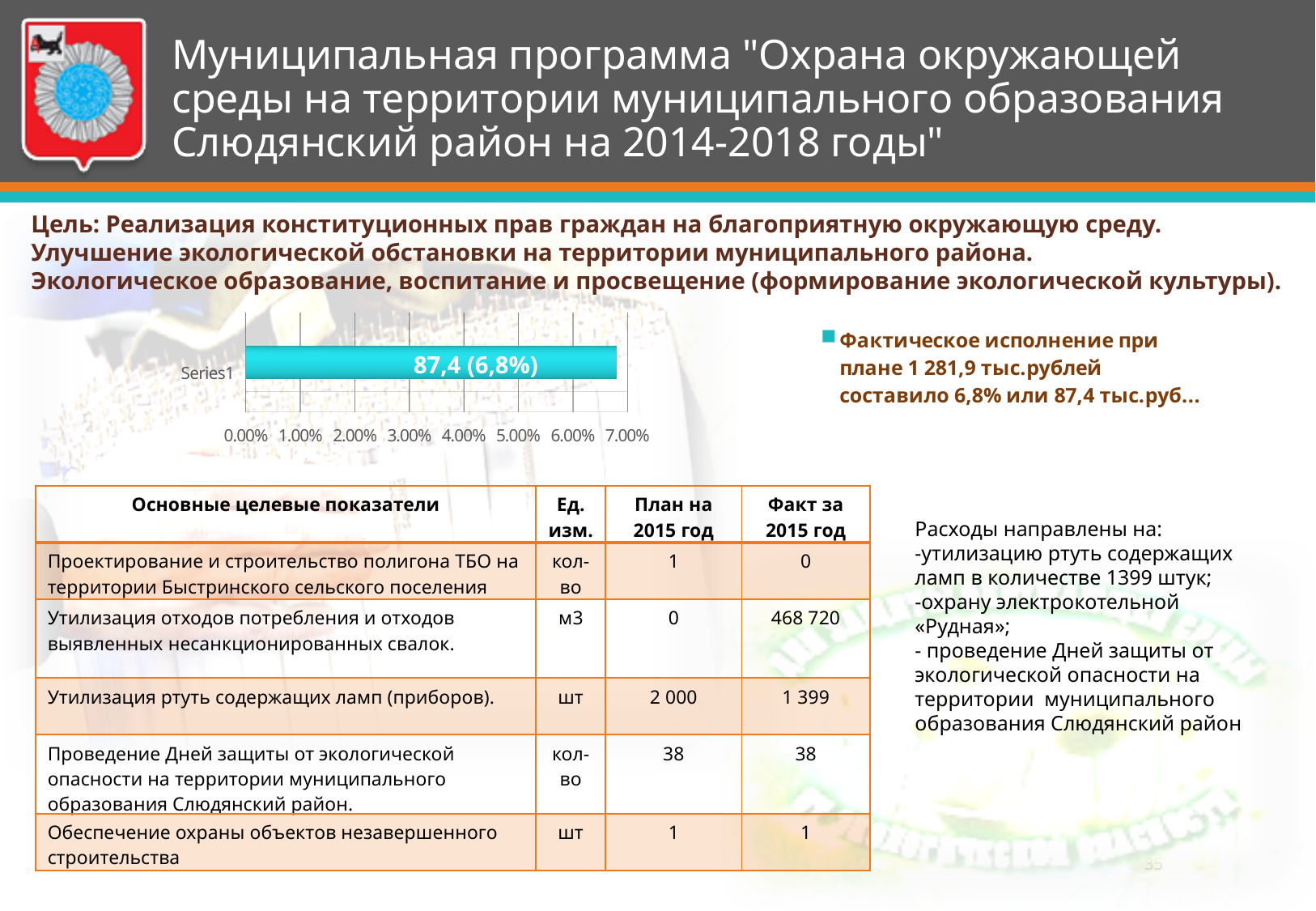
Is the value for Series1 greater or less than 5.00%? greater What is the category label shown next to the bar in the chart? Series1 Is the value for Series1 greater or less than 7.00%? less What kind of chart is shown on the slide? bar chart What is the highest tick value shown on the x axis of the chart? 7.00% What is the data label printed on the bar in the chart? 87,4 (6,8%) How many bars are plotted in the chart? 1 Is the value for Series1 greater or less than 6.00%? greater